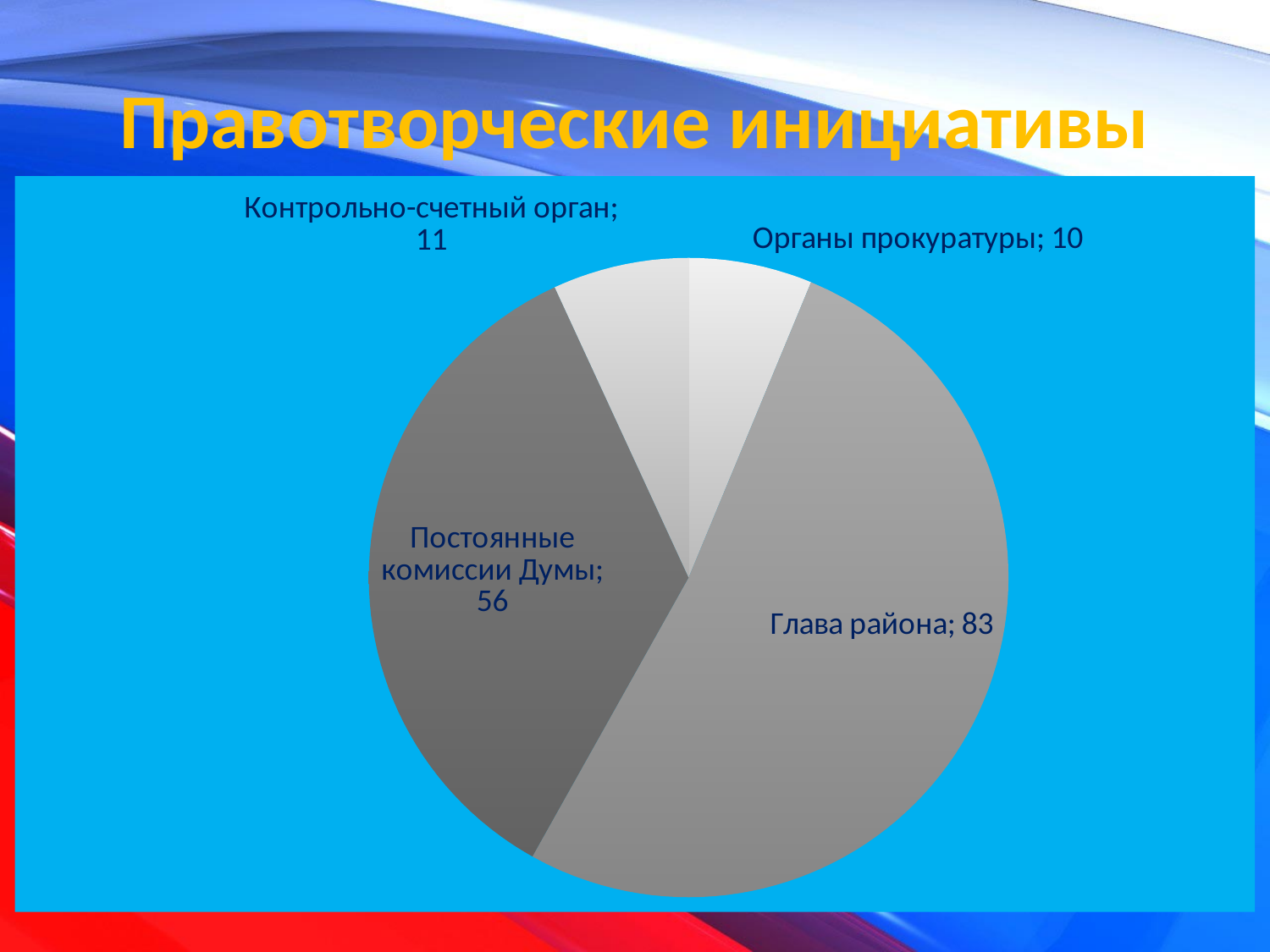
What is the value for Постоянные комиссии Думы? 56 How many categories are shown in the pie chart? 4 Which category has the smallest value? Органы прокуратуры What is the value for Контрольно-счетный орган? 11 What is the value for Органы прокуратуры? 10 Which is larger, the value for Контрольно-счетный орган or the value for Органы прокуратуры? Контрольно-счетный орган What share of the pie does Постоянные комиссии Думы represent? 35% Which category has the largest slice of the pie? Глава района What is the title of the slide containing the pie chart? Правотворческие инициативы What kind of chart is shown on the slide? pie chart What is the difference between the values for Глава района and Постоянные комиссии Думы? 27 What is the value for Глава района? 83